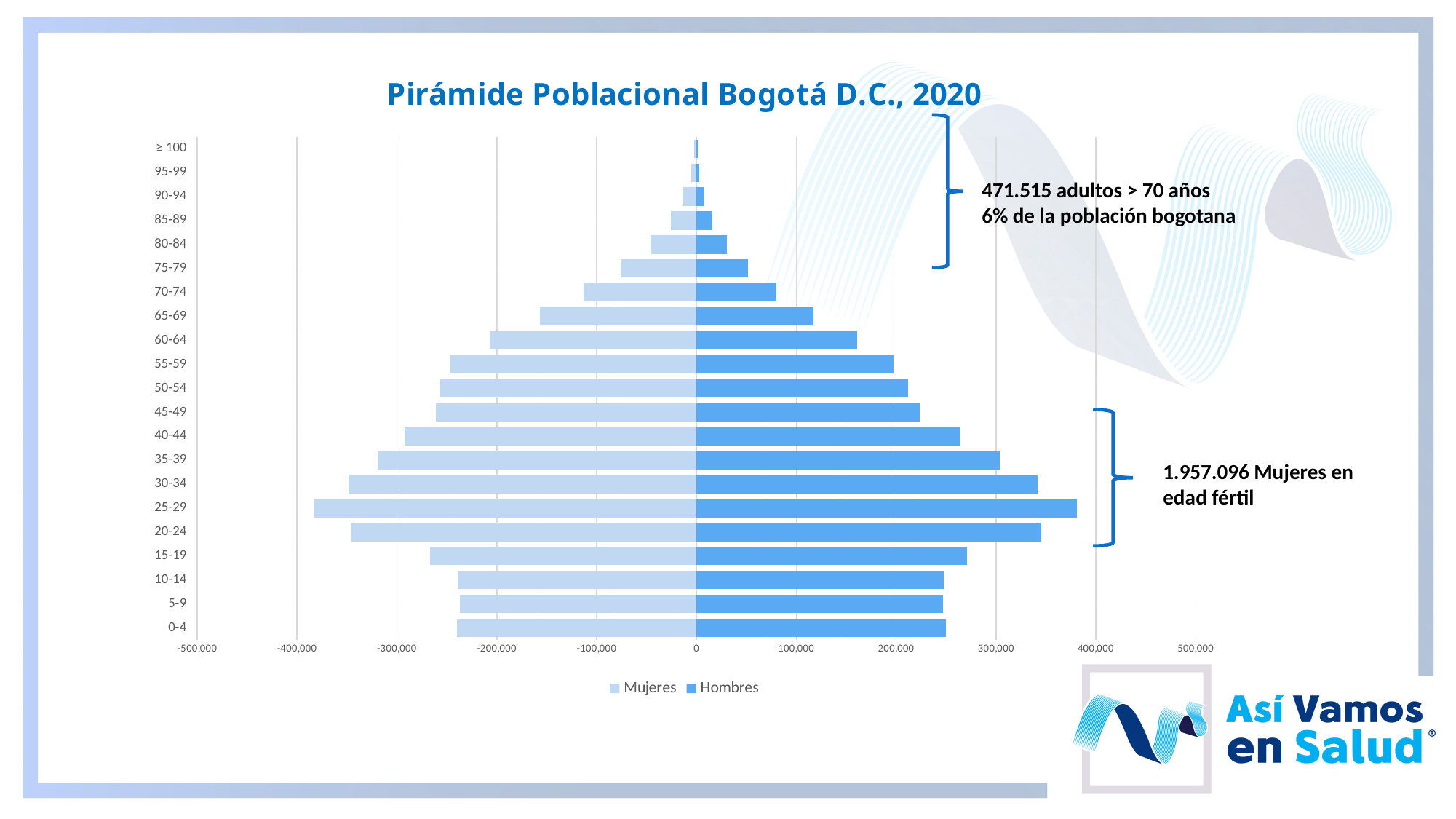
What kind of chart is shown on the slide? Bar chart (population pyramid) Which age group has the longest bar for Hombres? 25-29 Is the value for Hombres in the 25-29 age group greater or less than 300,000? greater Is the value for Hombres in the 70-74 age group greater or less than 100,000? less What are the two series named in the legend? Mujeres and Hombres How many age groups are shown on the vertical axis? 21 Which age group has the longest bar for Mujeres? 25-29 Which age group has the shortest bars for both Mujeres and Hombres? ≥ 100 Which is larger for Hombres: the 60-64 age group or the 65-69 age group? 60-64 What is the title of the chart? Pirámide Poblacional Bogotá D.C., 2020 Moving from the 25-29 age group up to the ≥ 100 age group, do the Hombres bars get longer or shorter? Shorter How many series does the legend list? 2